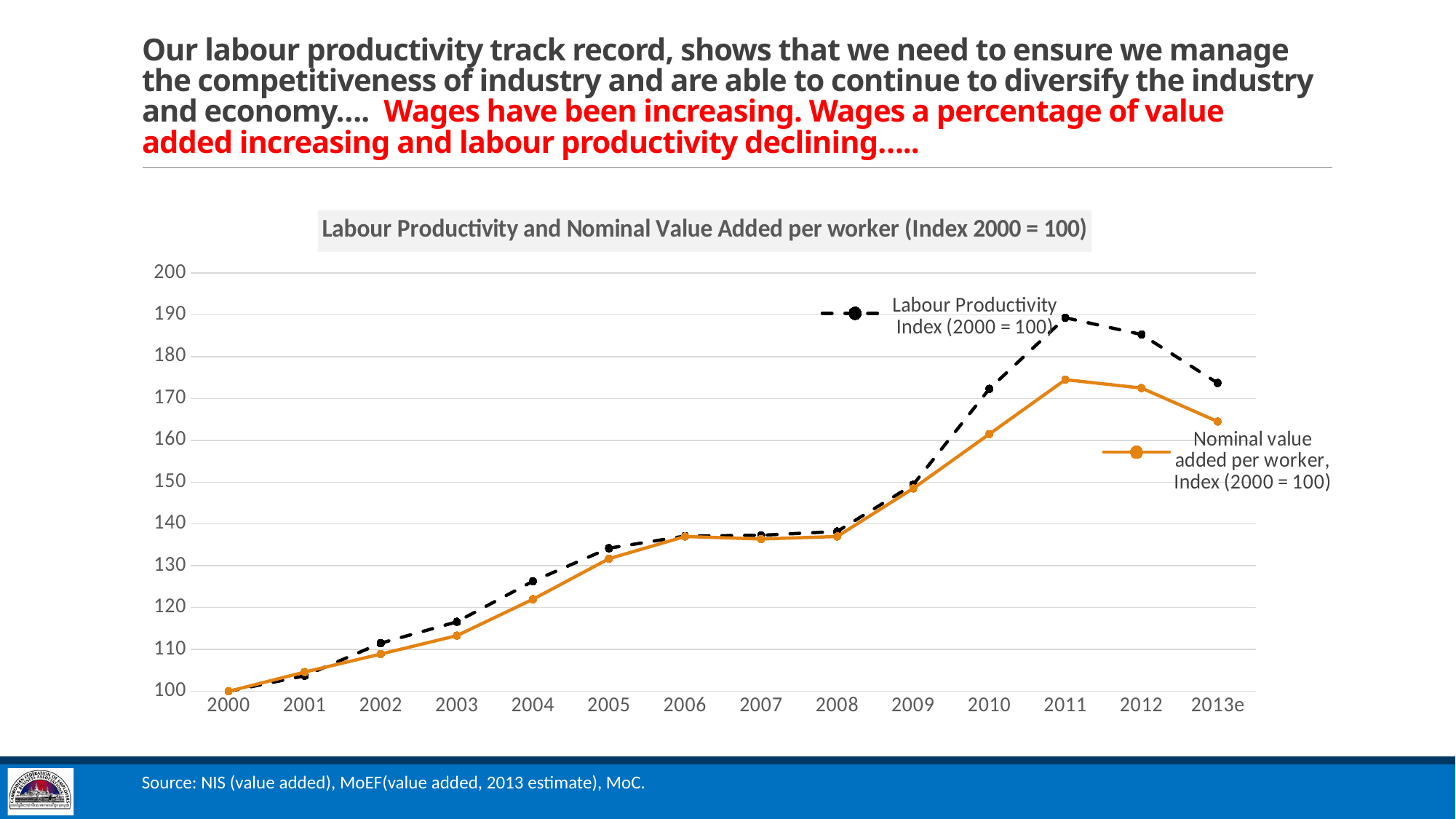
What is the value of the Labour Productivity Index in 2000? 100 Is the value of the Labour Productivity Index in 2011 greater or less than 180? greater Does the Labour Productivity Index rise or fall between 2011 and 2013e? Fall In which year does the Nominal value added per worker index reach its highest value? 2011 In which year is the Nominal value added per worker index at its lowest? 2000 In 2011, which series has the higher value: Labour Productivity Index or Nominal value added per worker index? Labour Productivity Index Is the value of the Nominal value added per worker index in 2013e greater or less than 170? less In which year does the Labour Productivity Index reach its highest value? 2011 Is the value of the Labour Productivity Index in 2004 greater or less than 120? greater How many years are plotted along the x axis of the chart? 14 How many series does the chart's legend list? 2 What type of chart is shown on the slide? Line chart